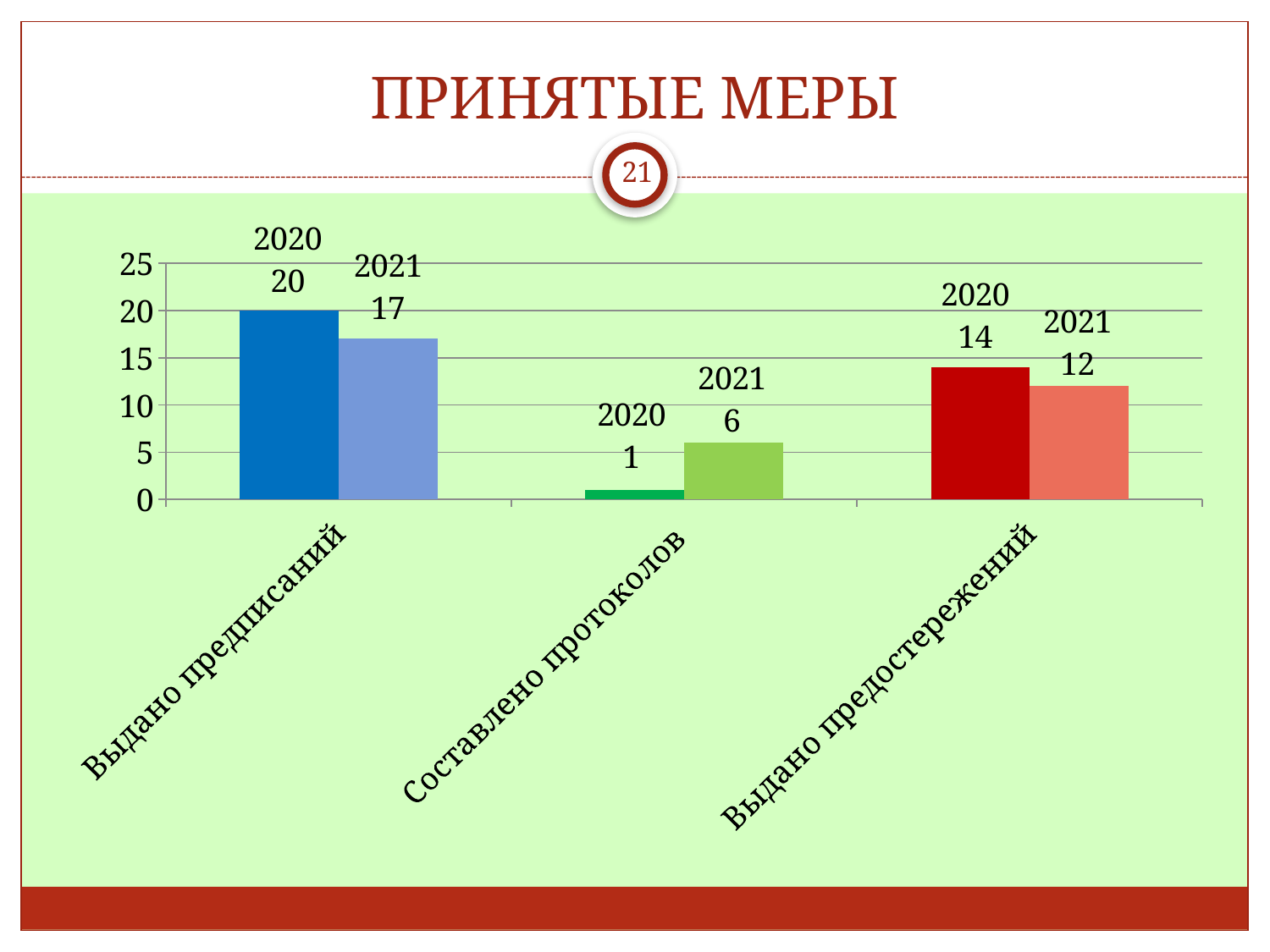
Which category has the lowest value for 2021? Составлено протоколов What is the value for 2020 in the "Выдано предостережений" category? 14 Which is larger for "Выдано предостережений": the 2020 value or the 2021 value? 2020 What is the difference between the 2020 and 2021 values for "Выдано предписаний"? 3 Which category has the highest value for 2020? Выдано предписаний What is the value for 2021 in the "Составлено протоколов" category? 6 What is the title of the slide containing the chart? ПРИНЯТЫЕ МЕРЫ What is the value for 2020 in the "Выдано предписаний" category? 20 What is the value for 2021 in the "Выдано предостережений" category? 12 What is the difference between the 2021 and 2020 values for "Составлено протоколов"? 5 What kind of chart is shown on the slide? Bar chart How many categories are shown on the x axis? 3